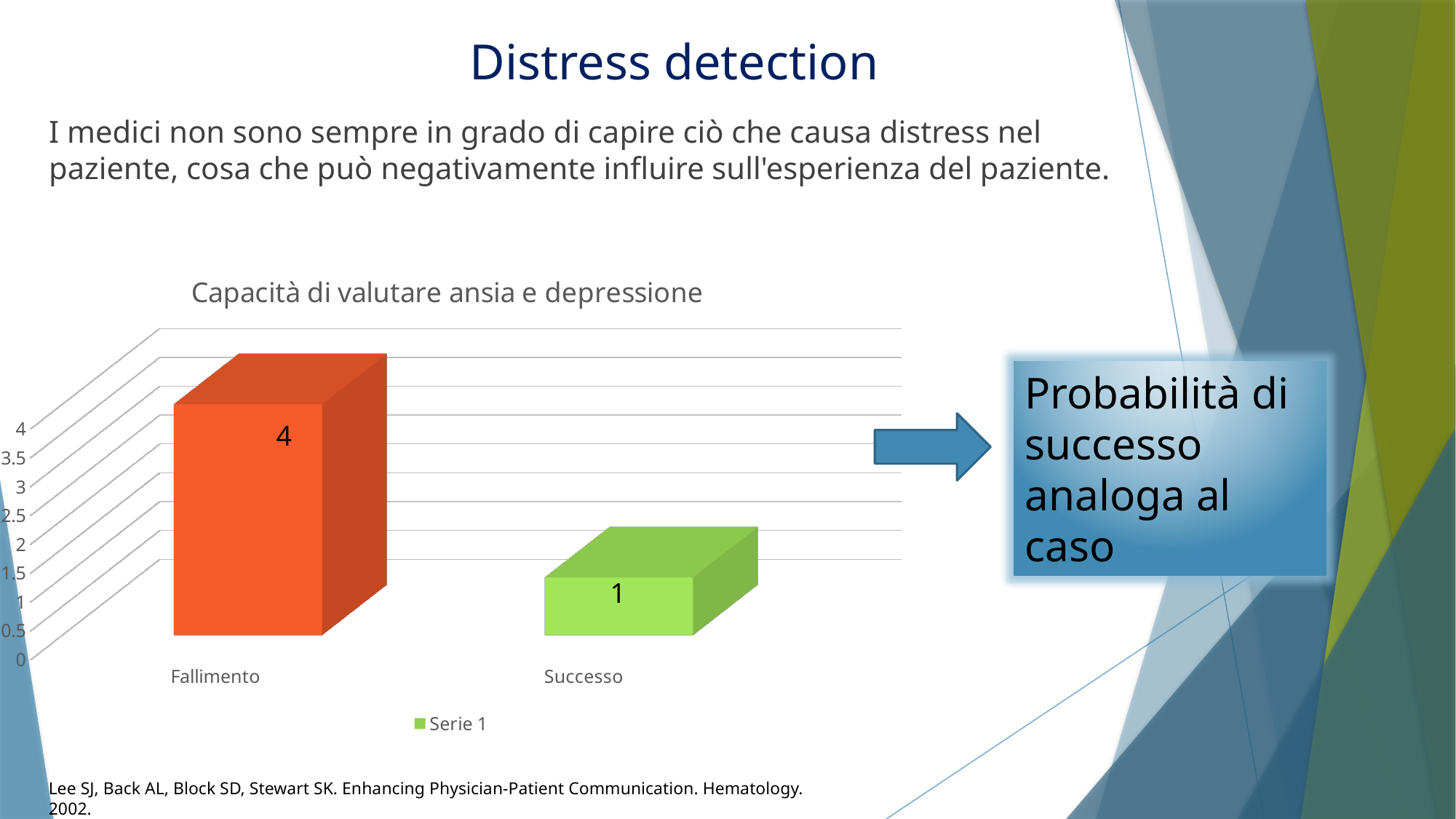
Which category has the lowest value? Successo How many categories are shown on the x axis? 2 Is the value for Fallimento greater or less than 3? greater How many series does the legend list? 1 What is the value for Fallimento? 4 What is the value for Successo? 1 What is the difference between the values for Fallimento and Successo? 3 What is the title of the chart? Capacità di valutare ansia e depressione What is the name of the series listed in the legend? Serie 1 Which is larger, the value for Fallimento or the value for Successo? Fallimento Which category has the highest value? Fallimento What kind of chart is shown? bar chart